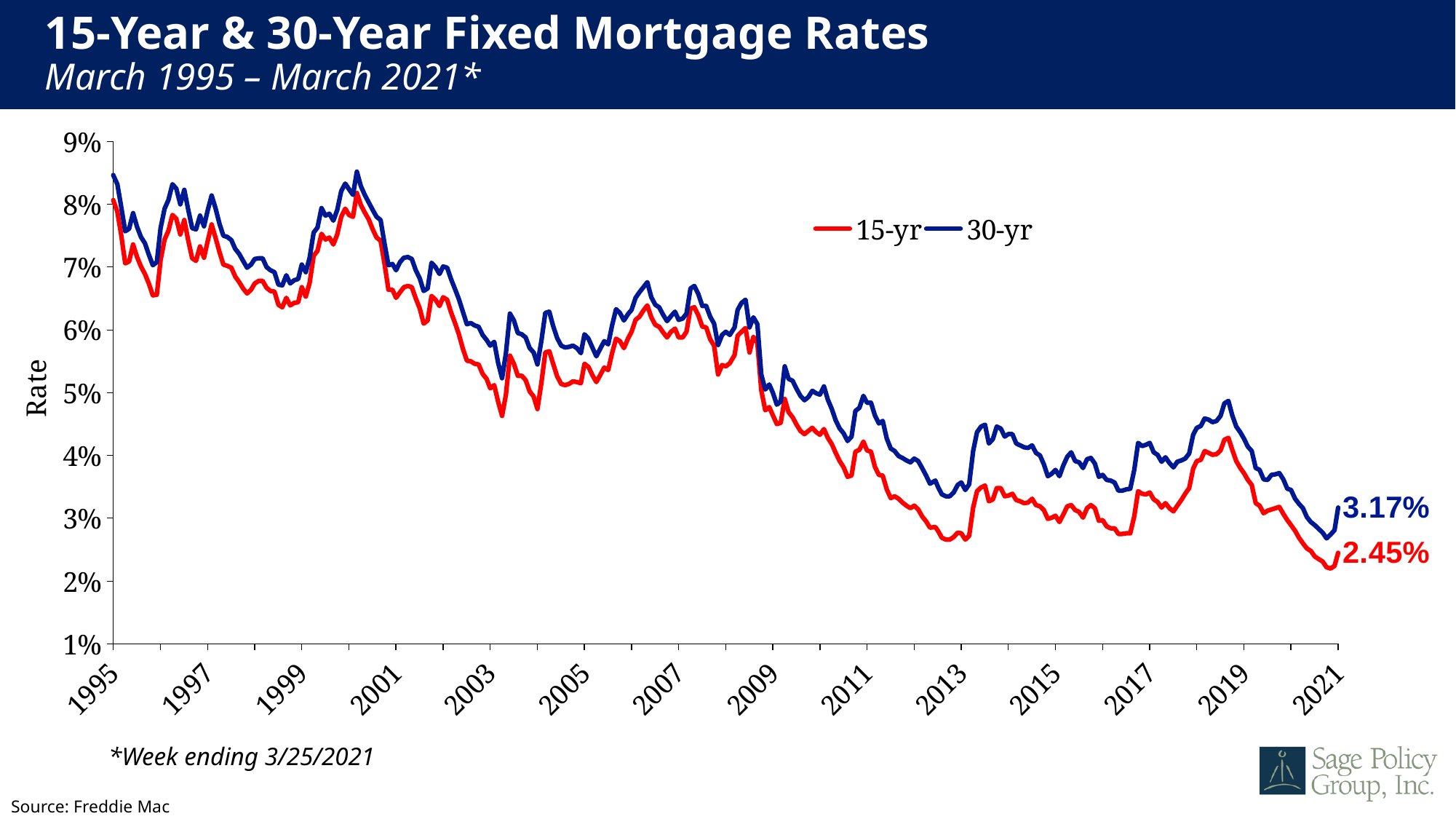
What is the 15-yr rate shown at the end of the series in March 2021? 2.45% Is the 30-yr rate at the start of the series in 1995 greater or less than 8%? greater What is the source cited for the chart data? Freddie Mac What kind of chart is shown on the slide? Line chart At the end of the series in March 2021, which series has the higher rate, 15-yr or 30-yr? 30-yr How many series does the legend list? 2 Is the 30-yr rate at its peak around 2000 greater or less than 8%? greater Which colour is used for the 15-yr series? Red What is the 30-yr rate shown at the end of the series in March 2021? 3.17% Do mortgage rates generally rise or fall from 1995 to 2021 in this chart? Fall What is the difference between the labelled 30-yr rate (3.17%) and the labelled 15-yr rate (2.45%) at the end of the series? 0.72 percentage points Is the 15-yr rate at its low point around 2013 greater or less than 3%? less